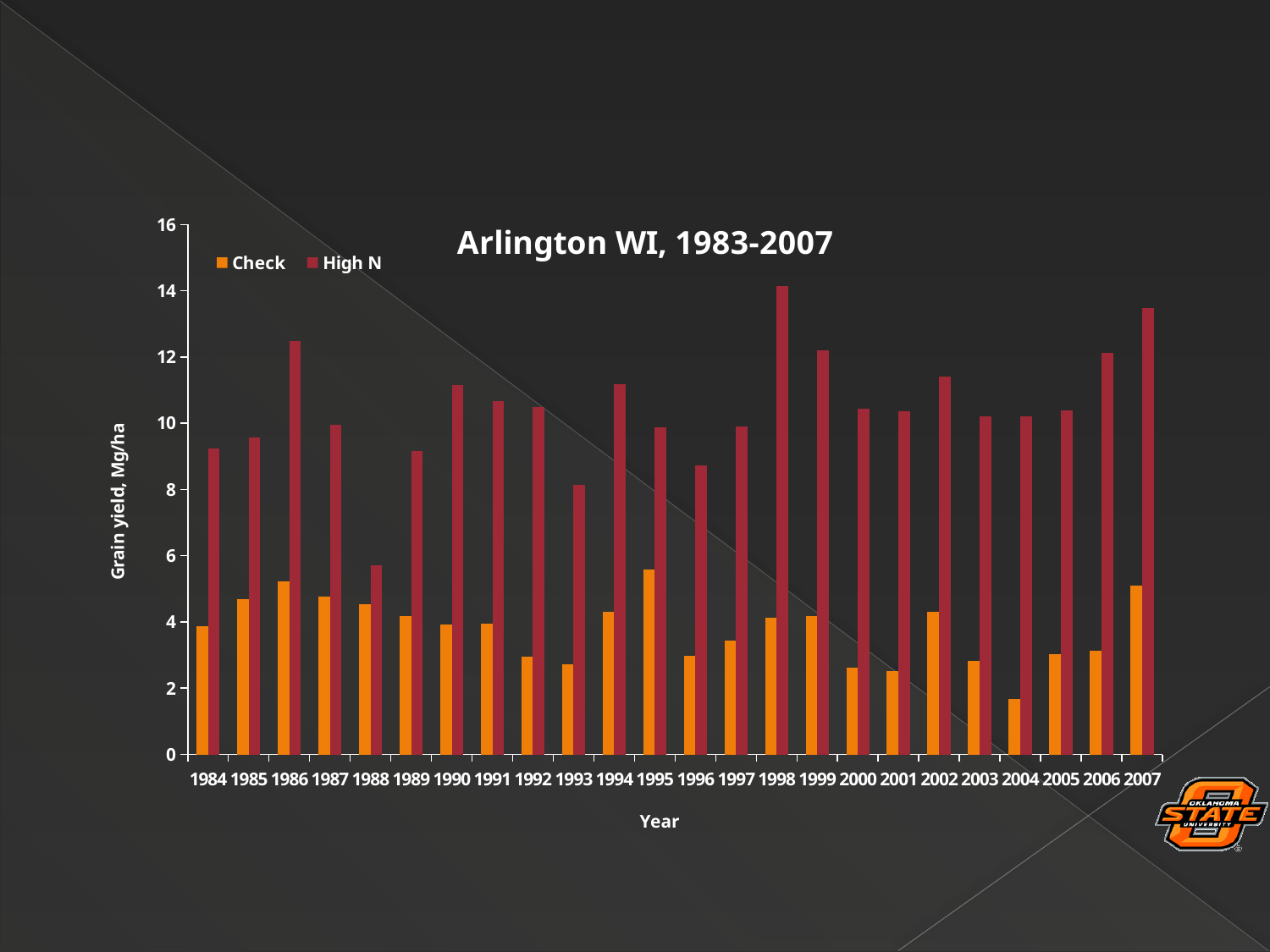
Is the Check value for 2004 greater or less than 2? less Is the High N value for 1988 greater or less than 8? less How many years are shown on the x axis? 24 What is the title of the chart? Arlington WI, 1983-2007 What kind of chart is shown on the slide? bar chart Which is larger, the High N value for 1986 or the High N value for 1987? 1986 What is the label of the vertical axis? Grain yield, Mg/ha In which year is the Check grain yield lowest? 2004 Is the High N value for 1998 greater or less than 12? greater In which year is the High N grain yield lowest? 1988 How many series does the legend list? 2 In which year is the High N grain yield highest? 1998